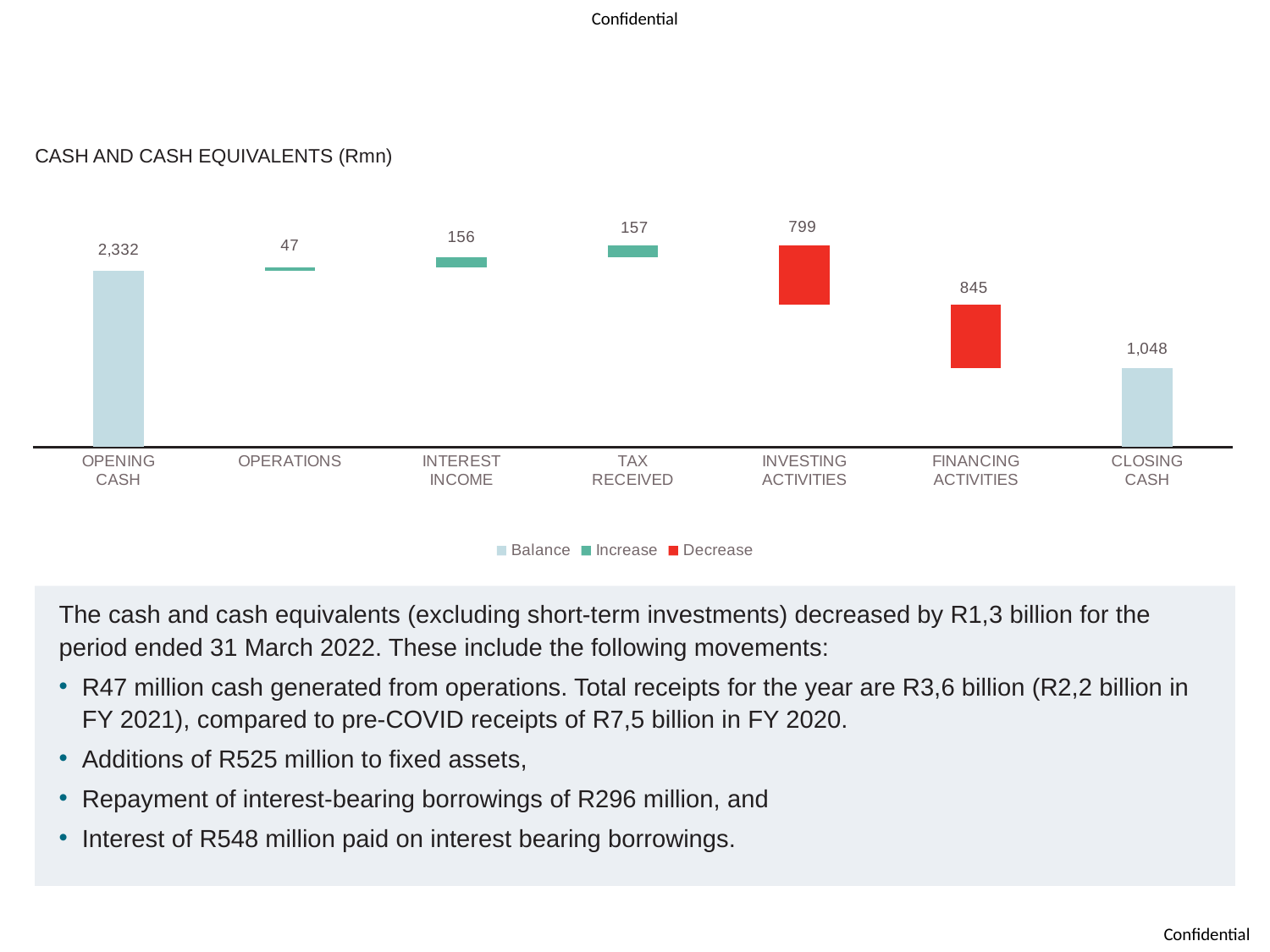
What is the value for OPENING CASH? 2,332 What is the difference between OPENING CASH and CLOSING CASH? 1,284 What is the difference between FINANCING ACTIVITIES and INVESTING ACTIVITIES? 46 What is the value for INVESTING ACTIVITIES? 799 What is the value for OPERATIONS? 47 What is the value for FINANCING ACTIVITIES? 845 Which category has the lowest value? OPERATIONS How many series does the legend list? 3 Which category has the highest value? OPENING CASH How many categories are shown on the x axis? 7 What is the value for CLOSING CASH? 1,048 Which is larger, INVESTING ACTIVITIES or FINANCING ACTIVITIES? FINANCING ACTIVITIES